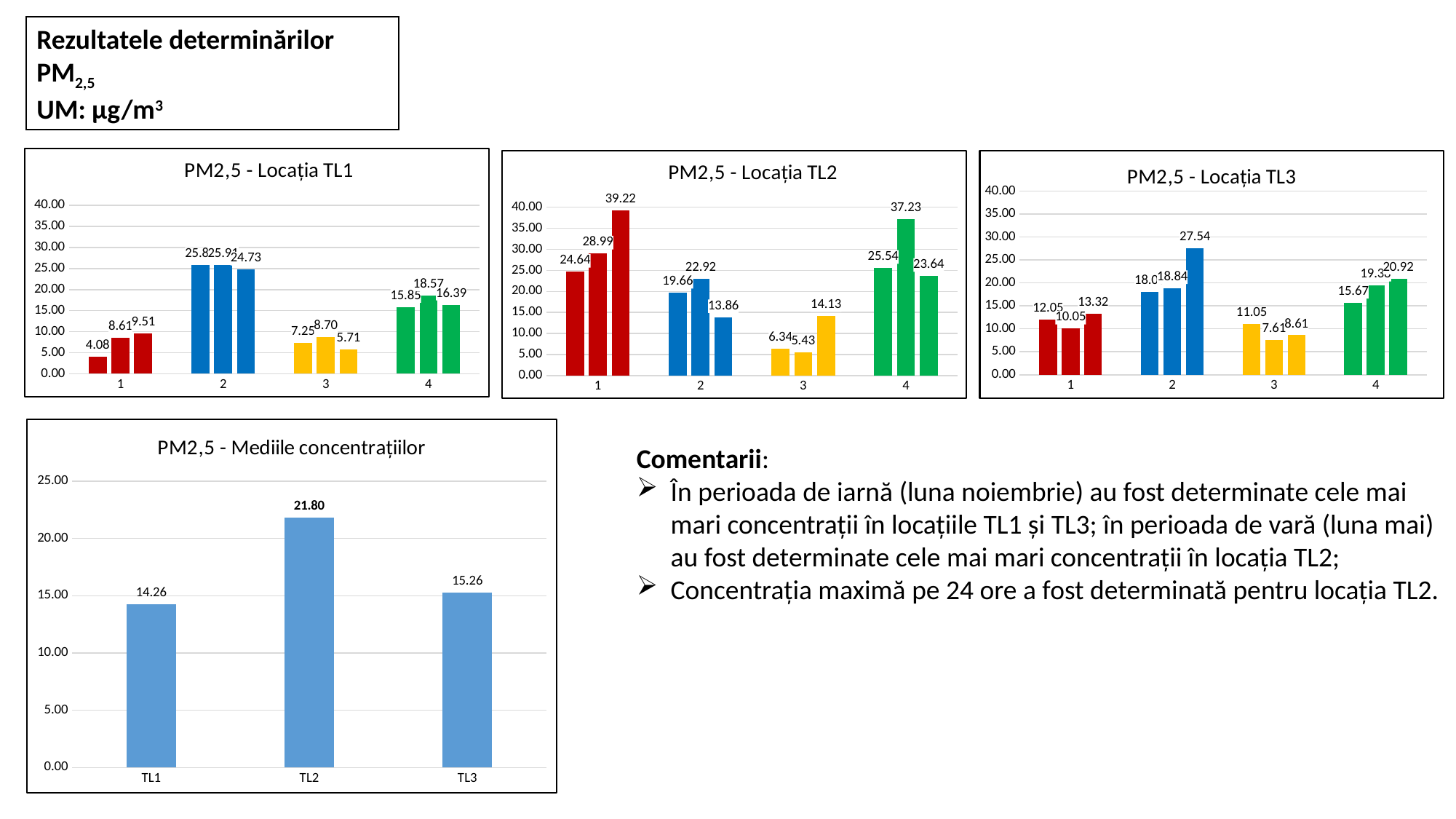
In the 'PM2,5 - Locația TL2' chart, what is the value of the third bar in group 3? 14.13 What type of chart is 'PM2,5 - Locația TL2'? Bar chart In the 'PM2,5 - Mediile concentrațiilor' chart, what is the value for TL2? 21.80 In the 'PM2,5 - Locația TL1' chart, is the value of the second bar in group 4 greater or less than 15.00? greater In the 'PM2,5 - Mediile concentrațiilor' chart, how many bars are plotted? 3 In the 'PM2,5 - Locația TL3' chart, which is larger: the first bar in group 3 or the second bar in group 3? The first bar in group 3 (11.05) In the 'PM2,5 - Locația TL2' chart, what is the highest value shown? 39.22 How many groups of bars are shown on the x axis of the 'PM2,5 - Locația TL1' chart? 4 In the 'PM2,5 - Mediile concentrațiilor' chart, what is the difference between TL2 and TL3? 6.54 In the 'PM2,5 - Locația TL3' chart, what is the value of the third bar in group 1? 13.32 In the 'PM2,5 - Mediile concentrațiilor' chart, which location has the lowest average? TL1 In the 'PM2,5 - Locația TL1' chart, what is the value of the first bar in group 1? 4.08